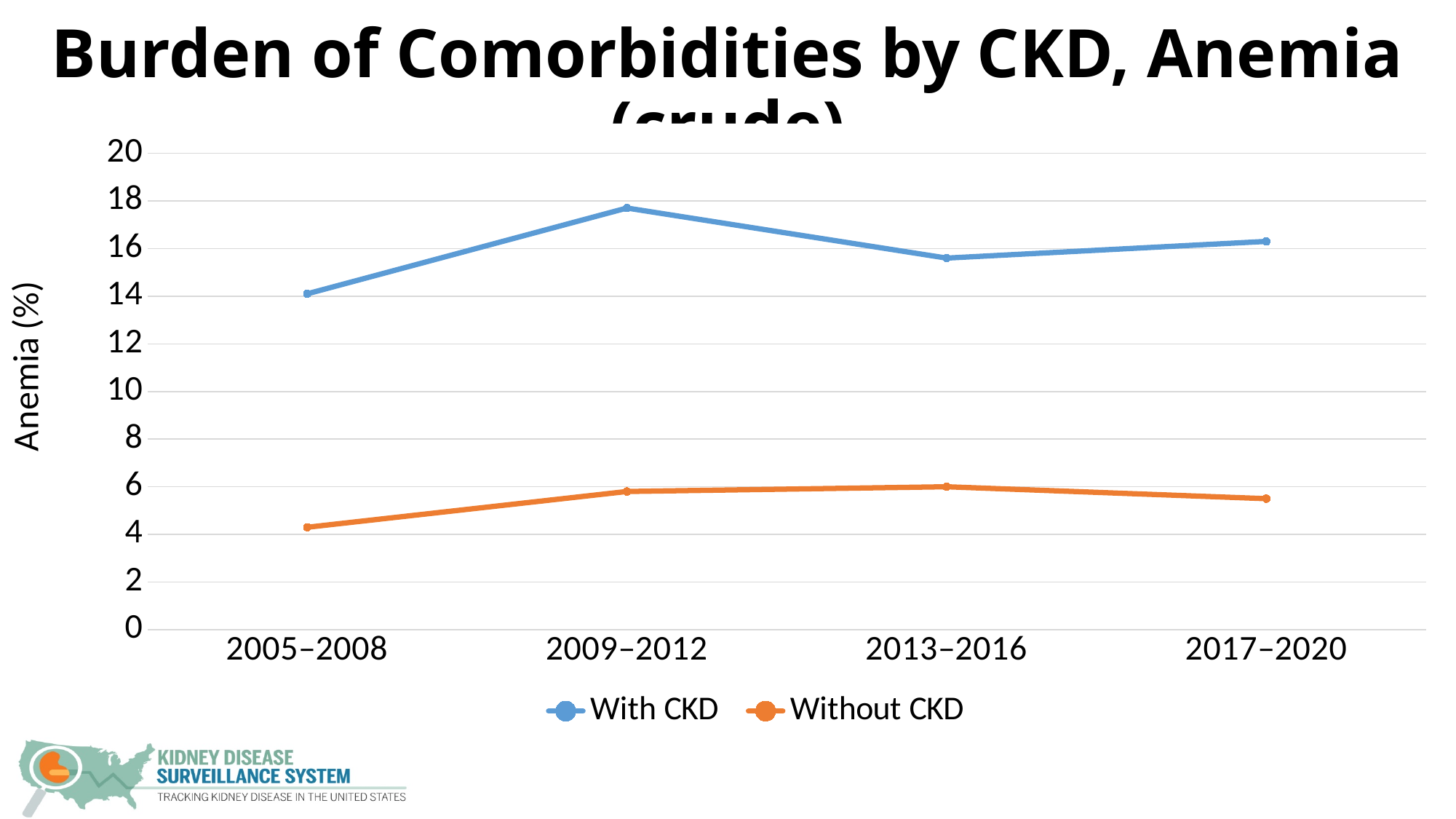
How many time periods are plotted along the x axis? 4 What kind of chart is shown on the slide? Line chart What is the label on the y axis? Anemia (%) How many series does the legend list? 2 Is the value for Without CKD in 2017–2020 greater or less than 6? less Is the value for With CKD in 2009–2012 greater or less than 16? greater Is the value for With CKD in 2005–2008 greater or less than 12? greater In which period is the Without CKD series at its lowest? 2005–2008 In which period is the With CKD series at its highest? 2009–2012 In which period is the With CKD series at its lowest? 2005–2008 Which is larger in 2013–2016, the With CKD value or the Without CKD value? With CKD Does the With CKD series rise or fall from 2005–2008 to 2009–2012? rise